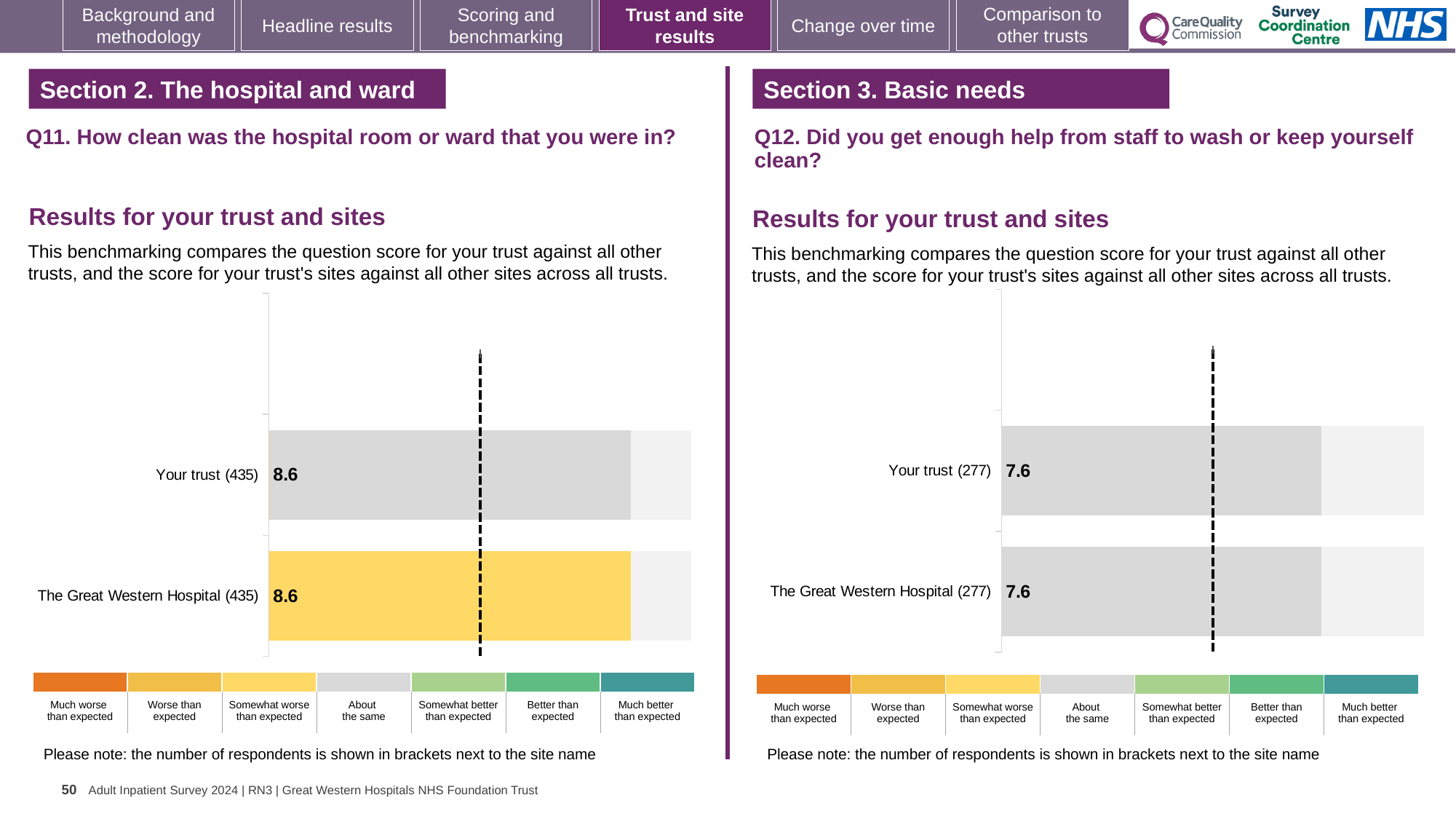
How many bars are plotted on the Q11 chart (left)? 2 How many bars are plotted on the Q12 chart (right)? 2 On the Q11 chart (left), what is the score for Your trust? 8.6 What kind of chart is used on the Q11 chart (left)? Bar chart On the Q11 chart (left), what is the difference between the score for Your trust and the score for The Great Western Hospital? 0 On the Q12 chart (right), how many respondents are shown in brackets next to The Great Western Hospital? 277 On the Q11 chart (left), what is the score for The Great Western Hospital? 8.6 On the Q11 chart (left), how many respondents are shown in brackets next to Your trust? 435 On the Q11 chart (left), which benchmark category does the yellow colour of The Great Western Hospital bar correspond to in the key? Somewhat worse than expected On the Q12 chart (right), what is the difference between the score for Your trust and the score for The Great Western Hospital? 0 On the Q12 chart (right), what is the score for The Great Western Hospital? 7.6 On the Q12 chart (right), what is the score for Your trust? 7.6